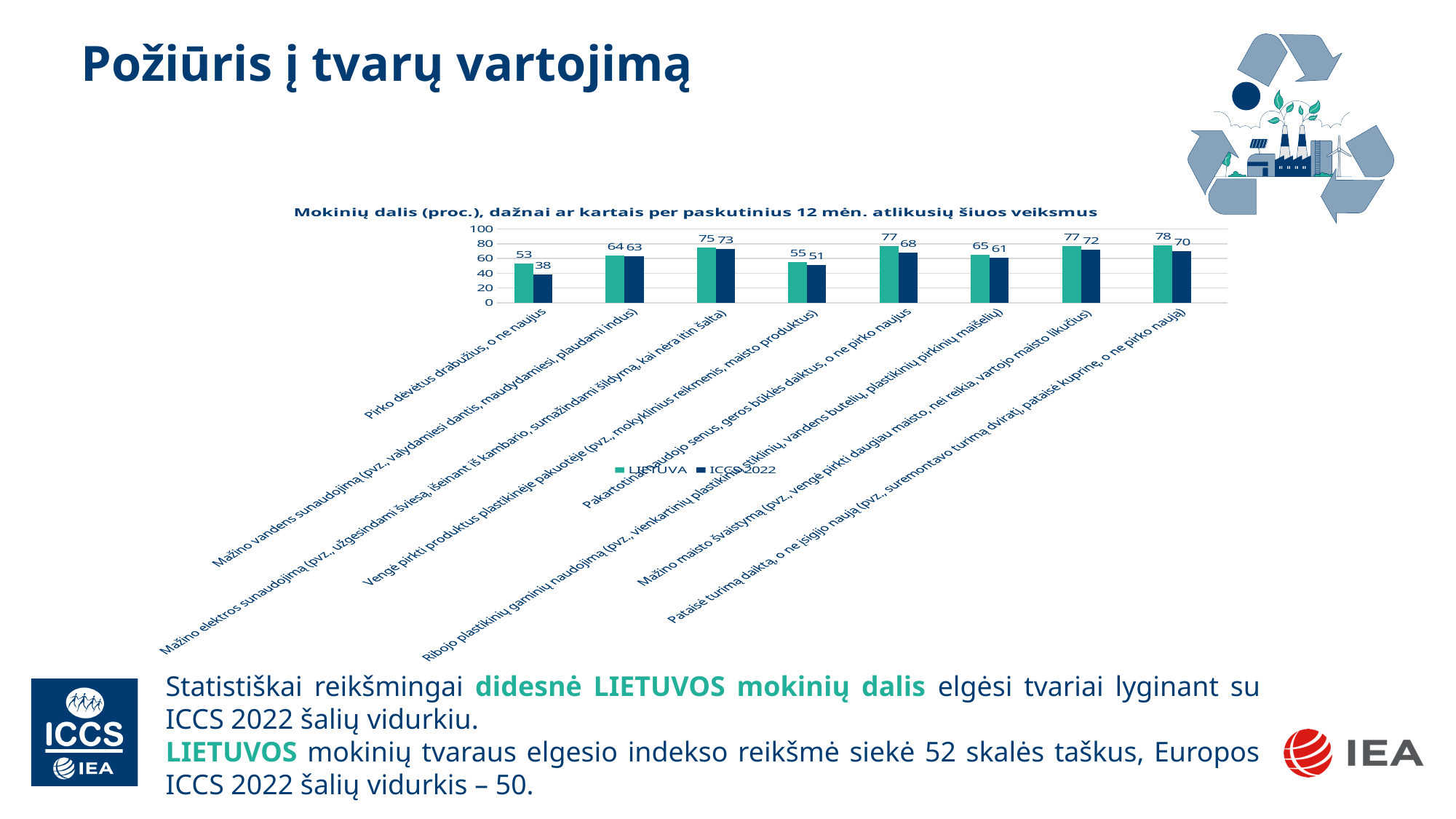
What is the difference between the LIETUVA and ICCS 2022 values for "Pakartotinai naudojo senus, geros būklės daiktus, o ne pirko naujus"? 9 What is the ICCS 2022 value for "Mažino maisto švaistymą"? 72 What is the ICCS 2022 value for "Pirko dėvėtus drabužius, o ne naujus"? 38 Which is larger for "Vengė pirkti produktus plastikinėje pakuotėje": the LIETUVA value or the ICCS 2022 value? LIETUVA How many series does the legend list? 2 What is the LIETUVA value for "Pirko dėvėtus drabužius, o ne naujus"? 53 Which series is shown in teal in the legend? LIETUVA How many categories are shown on the chart? 8 Which category has the lowest ICCS 2022 value? Pirko dėvėtus drabužius, o ne naujus Which category has the highest LIETUVA value? Pataisė turimą daiktą, o ne įsigijo naują What kind of chart is shown on the slide? bar chart Is the LIETUVA value for "Mažino elektros sunaudojimą" greater or less than 60? greater